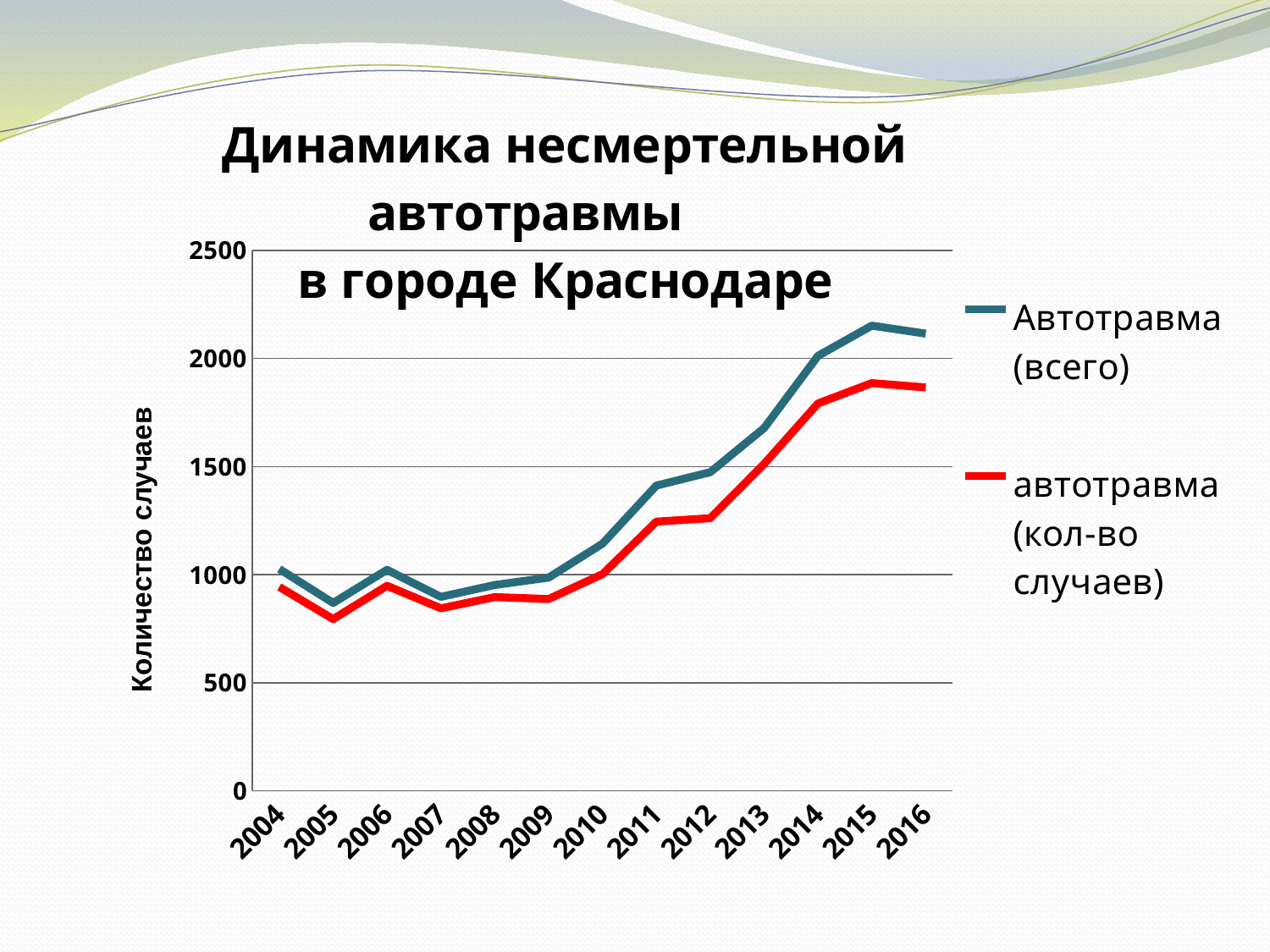
Do the values of the Автотравма (всего) series generally rise or fall from 2009 to 2015? rise Is the value for Автотравма (всего) in 2010 greater or less than 1000? greater What kind of chart is shown on the slide? line chart In which year does the Автотравма (всего) series reach its highest value? 2015 How many series does the legend list? 2 What is the label of the vertical axis? Количество случаев Which series has the larger value in 2016, Автотравма (всего) or автотравма (кол-во случаев)? Автотравма (всего) Is the value for автотравма (кол-во случаев) in 2005 greater or less than 1000? less In which year is the автотравма (кол-во случаев) series at its lowest? 2005 How many years are plotted along the x axis? 13 Is the value for Автотравма (всего) in 2015 greater or less than 2000? greater